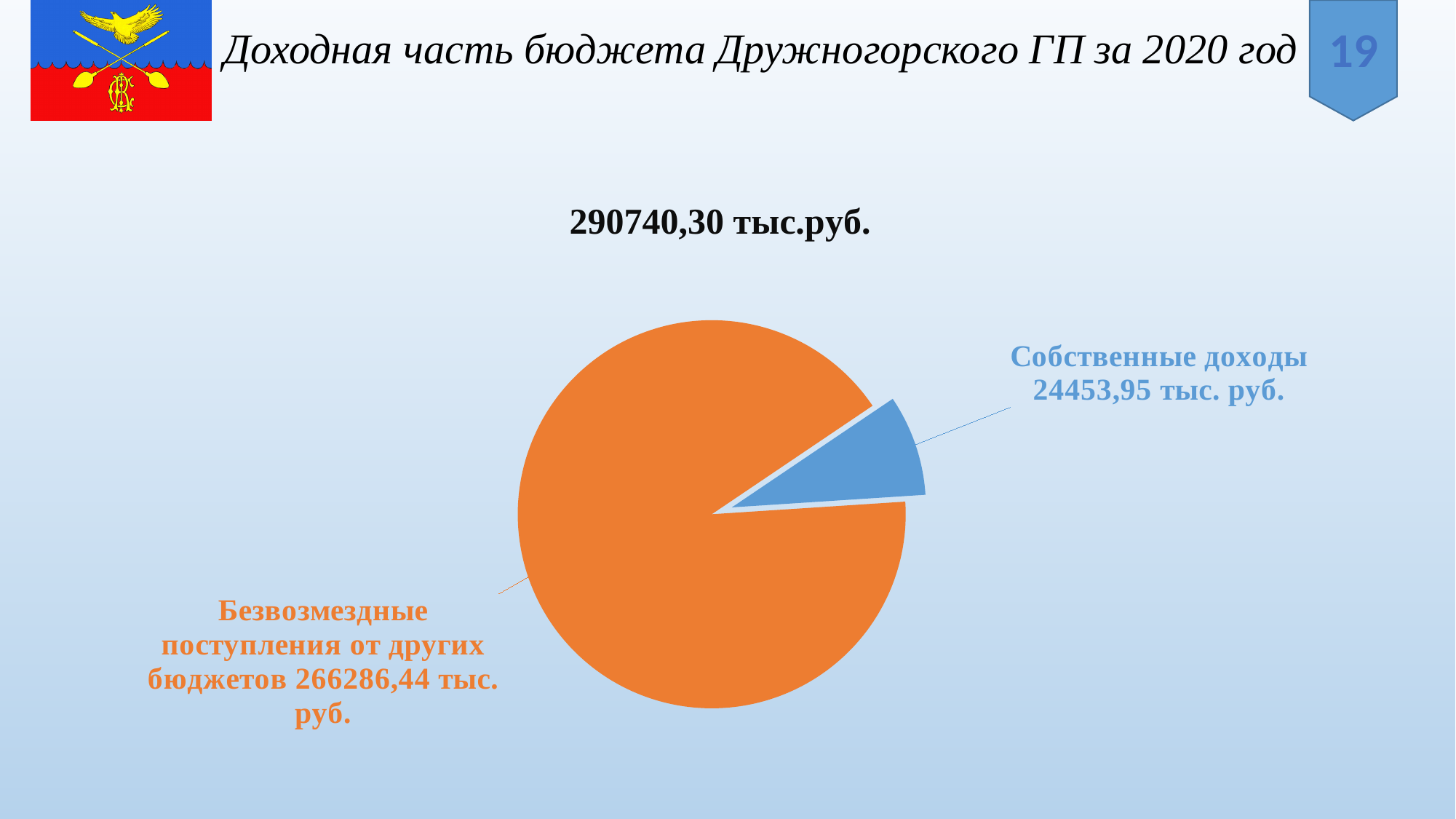
What is the value of the slice labelled «Собственные доходы»? 24453,95 тыс. руб. What is the title of the slide containing the chart? Доходная часть бюджета Дружногорского ГП за 2020 год Which is larger: «Собственные доходы» or «Безвозмездные поступления от других бюджетов»? Безвозмездные поступления от других бюджетов What total amount is shown above the pie chart? 290740,30 тыс.руб. What kind of chart is shown on the slide? Pie chart How many slices does the pie chart have? 2 What is the difference between «Безвозмездные поступления от других бюджетов» and «Собственные доходы»? 241832,49 тыс. руб. What colour is the slice for «Собственные доходы»? Blue Which slice of the pie is the largest? Безвозмездные поступления от других бюджетов What is the value of the slice labelled «Безвозмездные поступления от других бюджетов»? 266286,44 тыс. руб. Which slice of the pie is the smallest? Собственные доходы